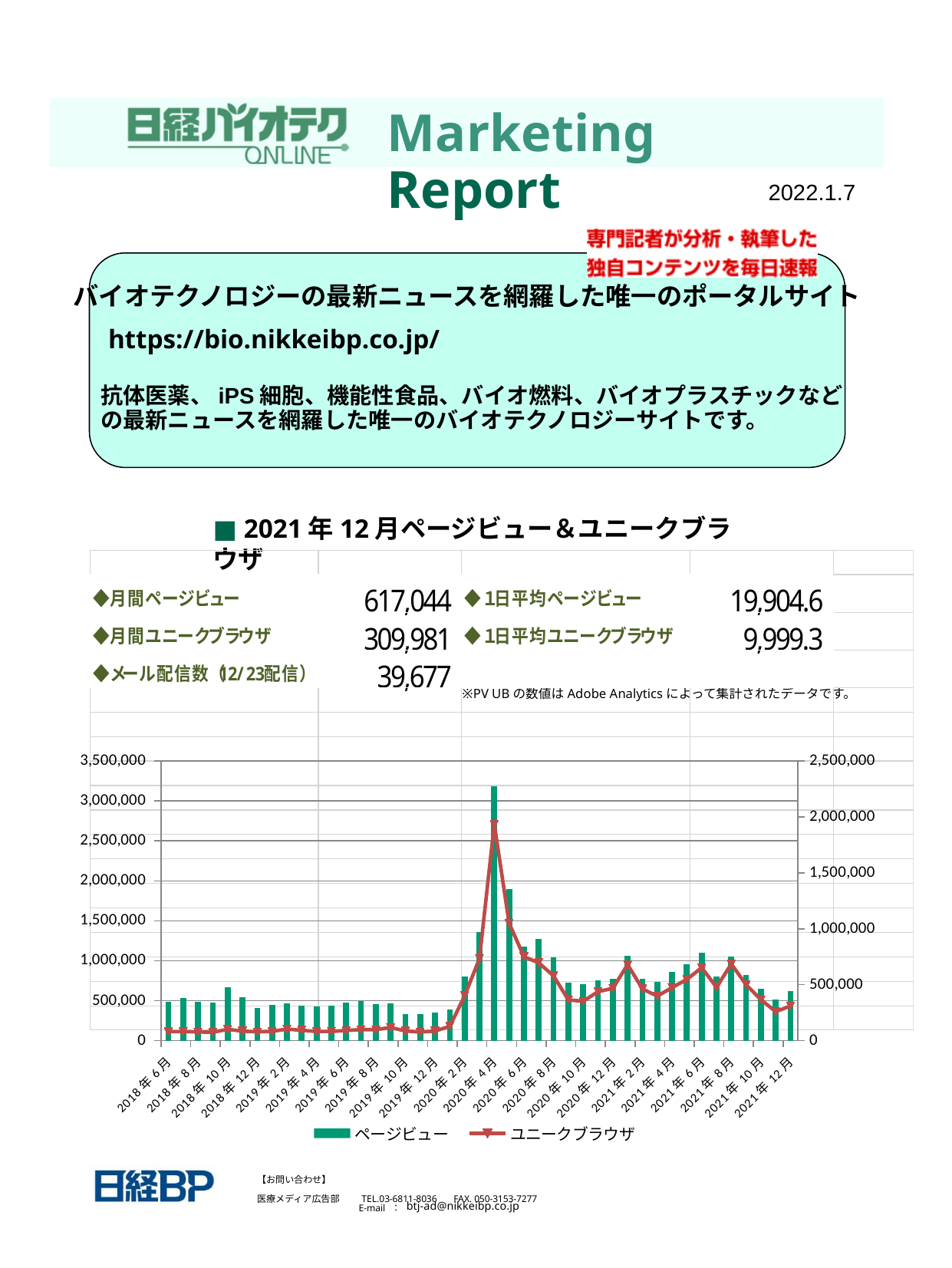
How many series does the chart legend list? 2 Which month has higher page views (ページビュー): 2020年4月 or 2020年5月? 2020年4月 Which month has a higher unique browsers (ユニークブラウザ) value: 2020年4月 or 2021年1月? 2020年4月 Is the page views (ページビュー) value for 2020年4月 greater or less than 3,000,000? greater Do the page views (ページビュー) bars rise or fall from 2020年4月 to 2020年10月? fall Is the page views (ページビュー) value for 2020年5月 greater or less than 1,500,000? greater What is the highest value shown on the left vertical axis of the chart? 3,500,000 Is the page views (ページビュー) value for 2018年6月 greater or less than 1,000,000? less In which month do the page views (ページビュー) bars reach their highest value? 2020年4月 What kind of chart is shown on the slide? A combined bar and line chart What are the two series named in the chart legend? ページビュー and ユニークブラウザ